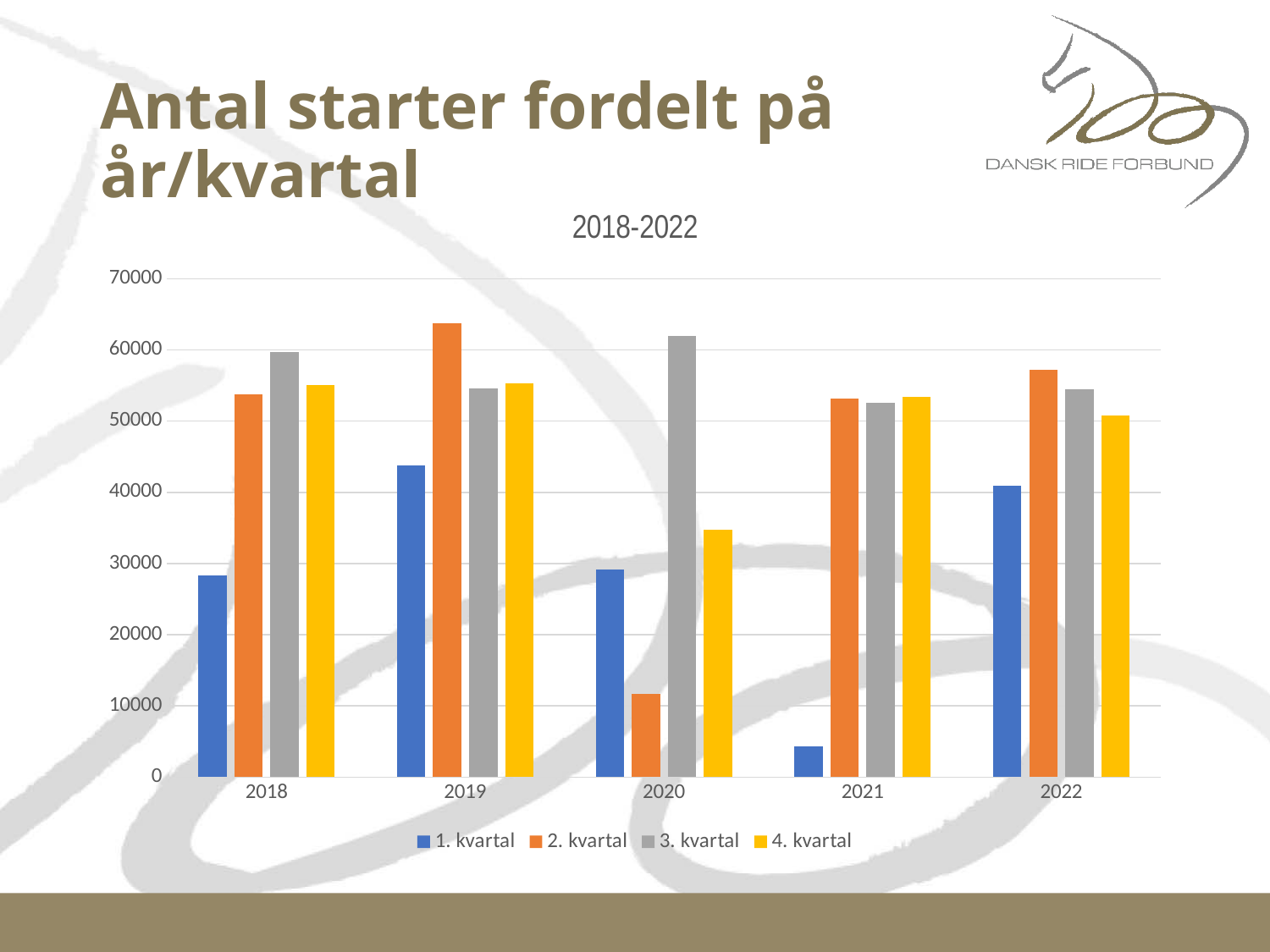
Which year has the highest value for 1. kvartal? 2019 How many series does the legend list? 4 Is the value for 1. kvartal in 2018 greater or less than 30000? less Is the value for 3. kvartal in 2020 greater or less than 60000? greater Which colour represents 4. kvartal in the legend? yellow In 2020, which is larger: the value for 3. kvartal or the value for 4. kvartal? 3. kvartal Is the value for 1. kvartal in 2021 greater or less than 10000? less What kind of chart is shown on the slide? bar chart Which year has the lowest value for 2. kvartal? 2020 How many years are shown along the x axis? 5 In 2018, which is larger: the value for 1. kvartal or the value for 2. kvartal? 2. kvartal Which year has the lowest value for 1. kvartal? 2021